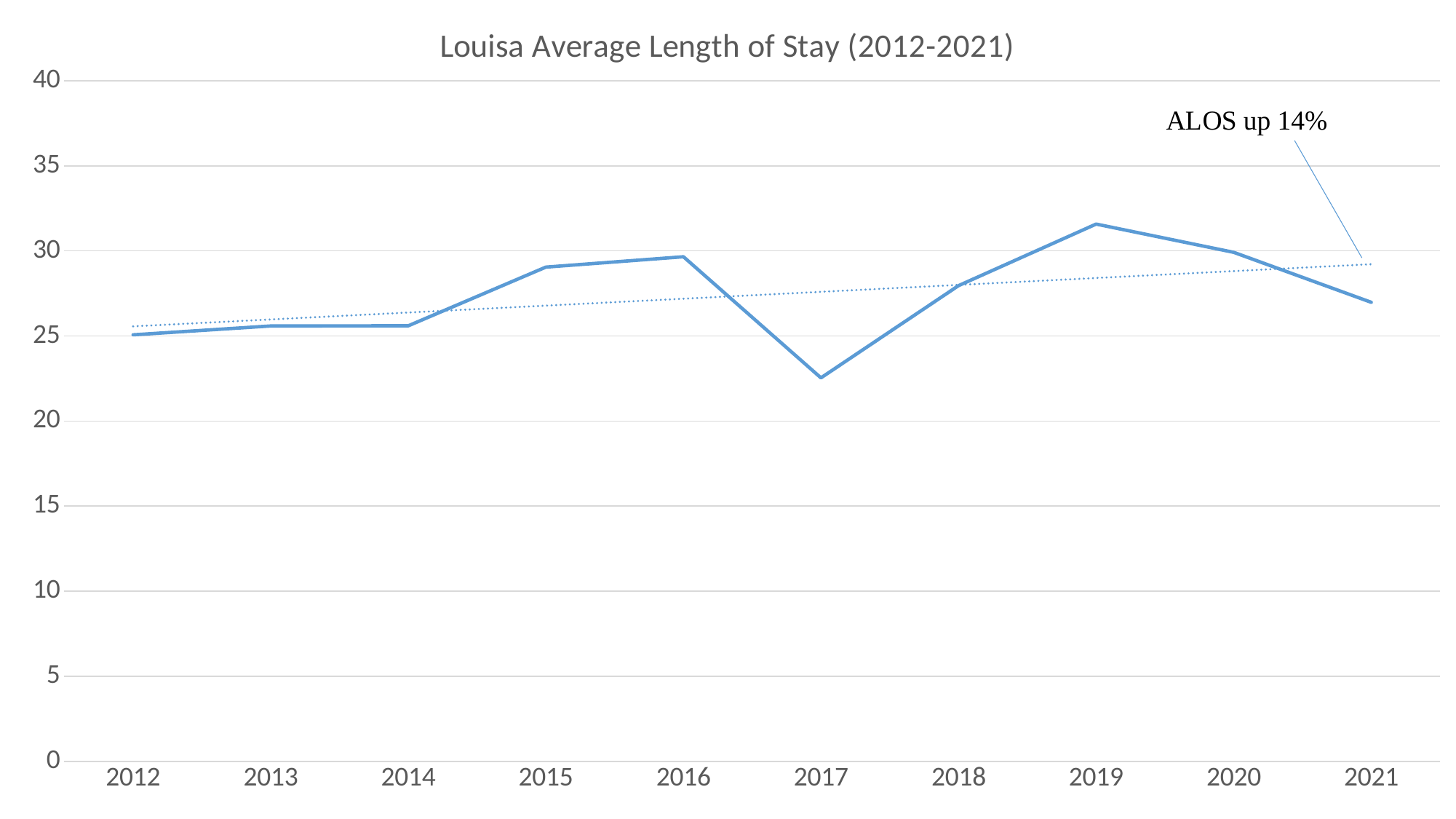
Is the value for 2019 greater or less than 30? greater Is the value for 2021 greater or less than 30? less Is the value for 2017 greater or less than 25? less Which year has the lowest average length of stay? 2017 Which year has the highest average length of stay? 2019 What does the annotation on the chart say about ALOS? ALOS up 14% How many years are plotted on the x axis of the chart? 10 Which year has the larger value, 2019 or 2017? 2019 What kind of chart is shown on the slide? line chart Which year has the larger value, 2015 or 2012? 2015 What is the title of the chart? Louisa Average Length of Stay (2012-2021)